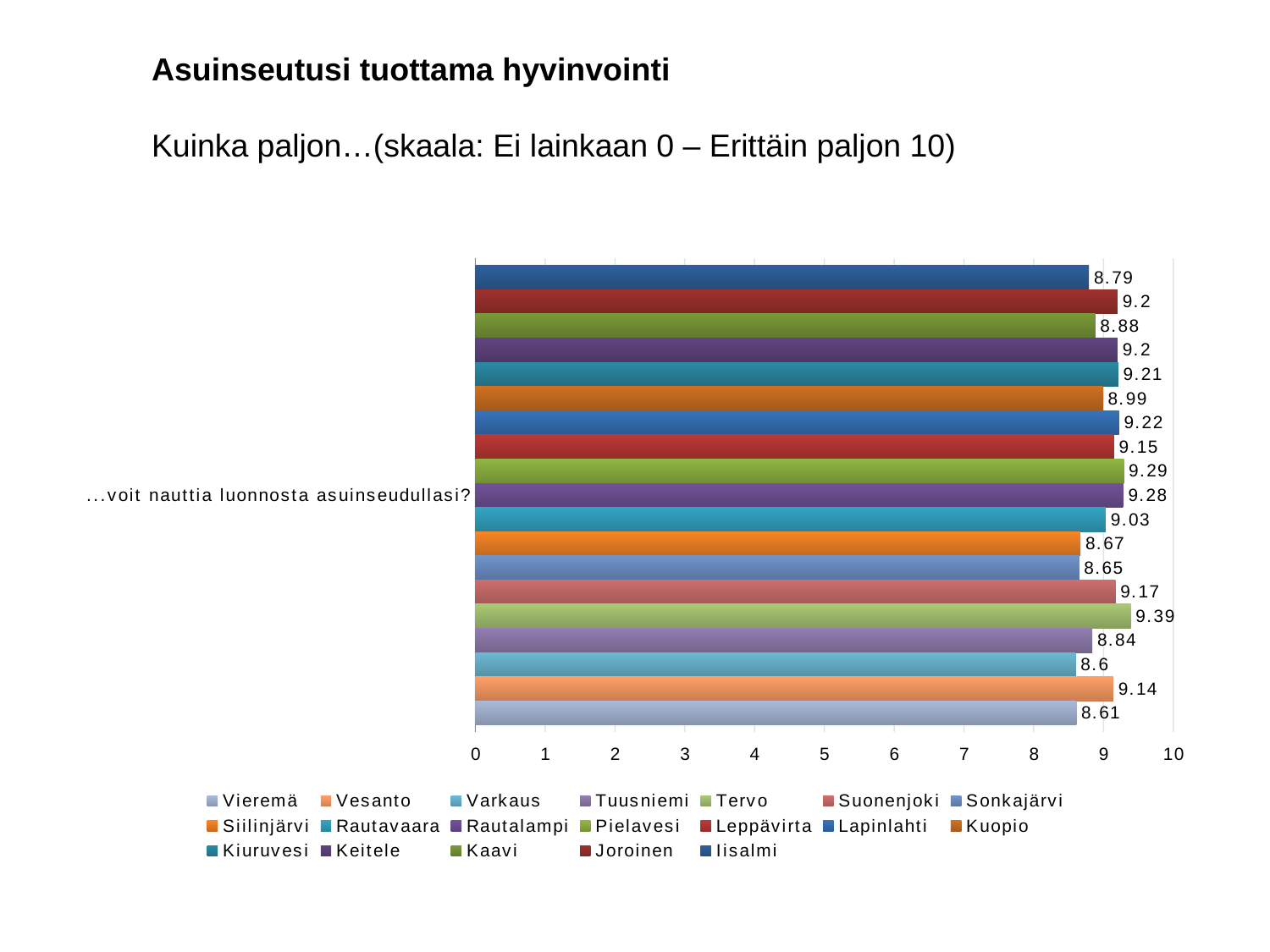
What is the value for Tervo? 9.39 Is the value for Siilinjärvi greater or less than 9? less What kind of chart is shown on the slide? bar chart Which has a larger value, Vesanto or Sonkajärvi? Vesanto How many series does the legend list? 19 Which municipality has the lowest value? Varkaus What is the difference between the values for Tervo and Varkaus? 0.79 What is the value for Kuopio? 8.99 What is the value for Rautavaara? 9.03 What is the value for Iisalmi? 8.79 What is the category label shown on the vertical axis of the chart? ...voit nauttia luonnosta asuinseudullasi? Which municipality has the highest value? Tervo